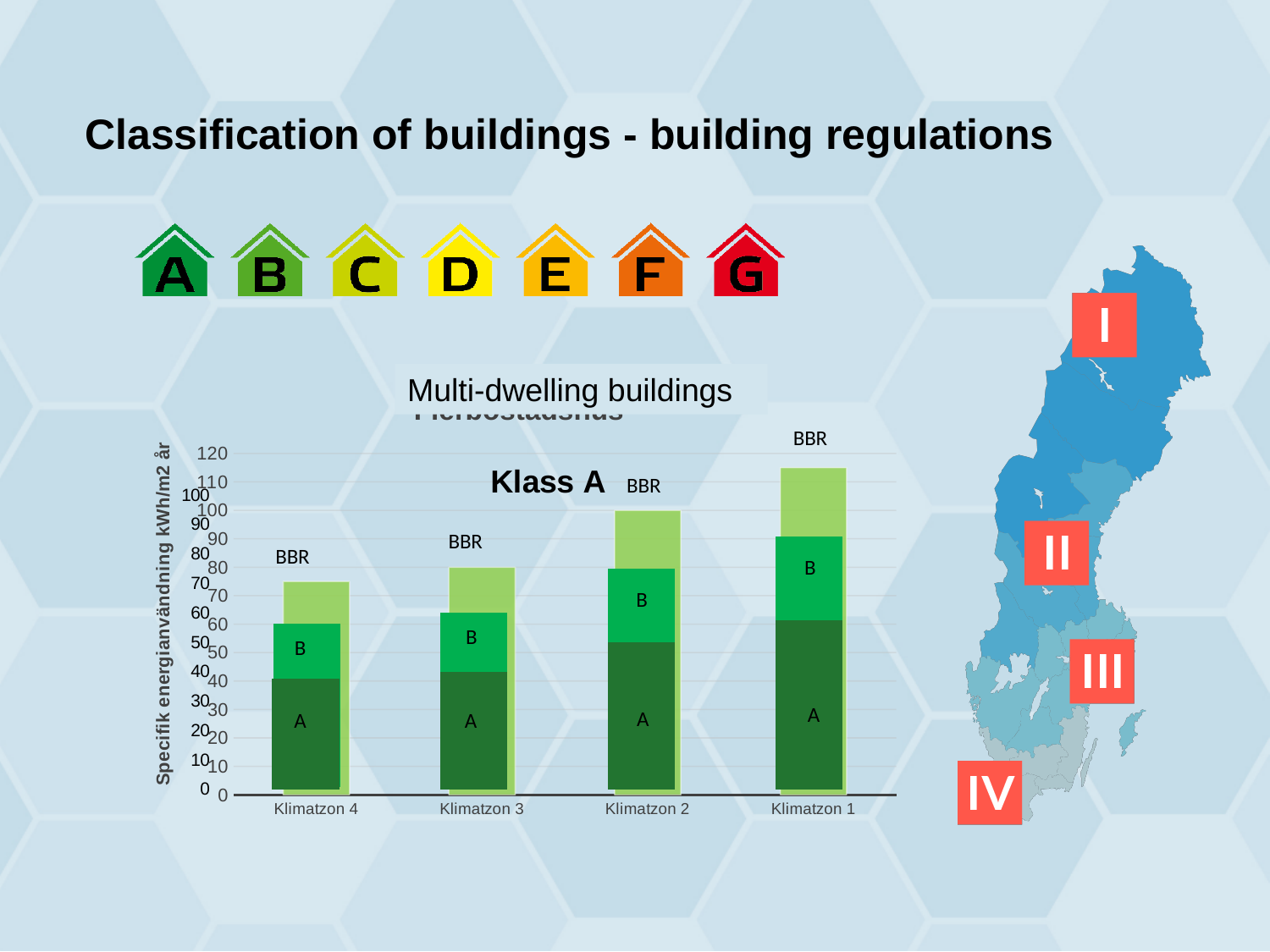
What title is shown above the chart? Multi-dwelling buildings Do the bar heights rise or fall moving left to right from Klimatzon 4 to Klimatzon 1? rise Is the total height of the Klimatzon 4 bar greater or less than 80? less Which bar is taller overall, Klimatzon 2 or Klimatzon 3? Klimatzon 2 Which climate zone has the shortest stacked bar in the chart? Klimatzon 4 What kind of chart is shown on the slide? bar chart Is the total height of the Klimatzon 1 bar greater or less than 110? greater What is the title of the y axis of the chart? Specifik energianvändning kWh/m2 år Which climate zone has the tallest stacked bar in the chart? Klimatzon 1 Is the top of the A segment for Klimatzon 3 greater or less than 50? less How many climate zone categories are shown on the x axis of the chart? 4